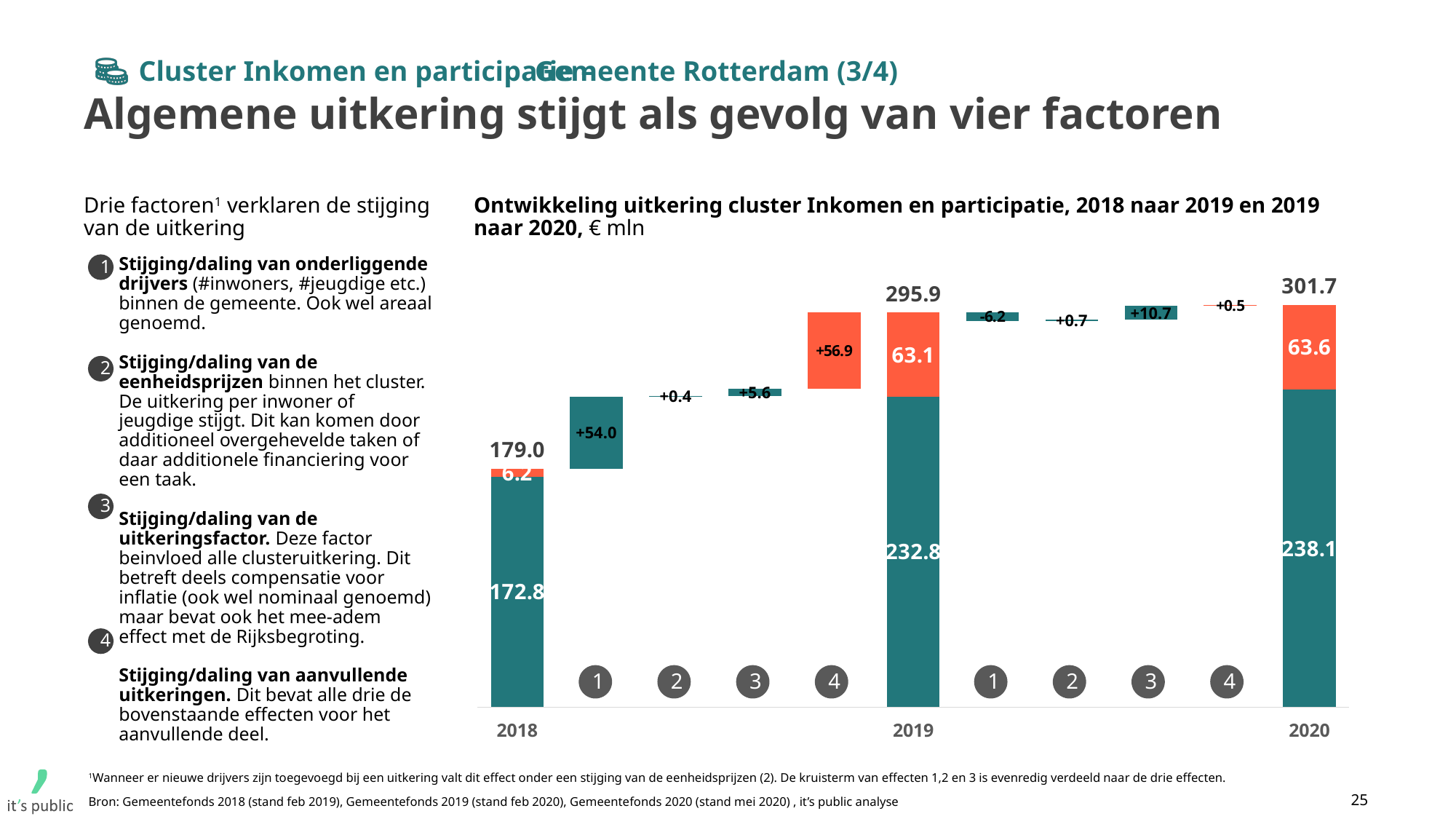
What is the value of the teal segment in the 2019 bar? 232.8 What is the value of the orange segment in the 2020 bar? 63.6 What unit is stated in the chart title? € mln Which of the four factors between 2018 and 2019 has the smallest value? Factor 2 (+0.4) What is the total value shown for 2020? 301.7 What is the total value shown for 2019? 295.9 Which of the four factors between 2019 and 2020 has the largest value? Factor 3 (+10.7) What is the difference between the 2020 total and the 2019 total? 5.8 What is the value of factor 4 between 2018 and 2019? +56.9 What is the total value shown for 2018? 179.0 Is the teal segment larger in the 2020 bar or the 2018 bar? 2020 What is the value of factor 1 between 2019 and 2020? -6.2